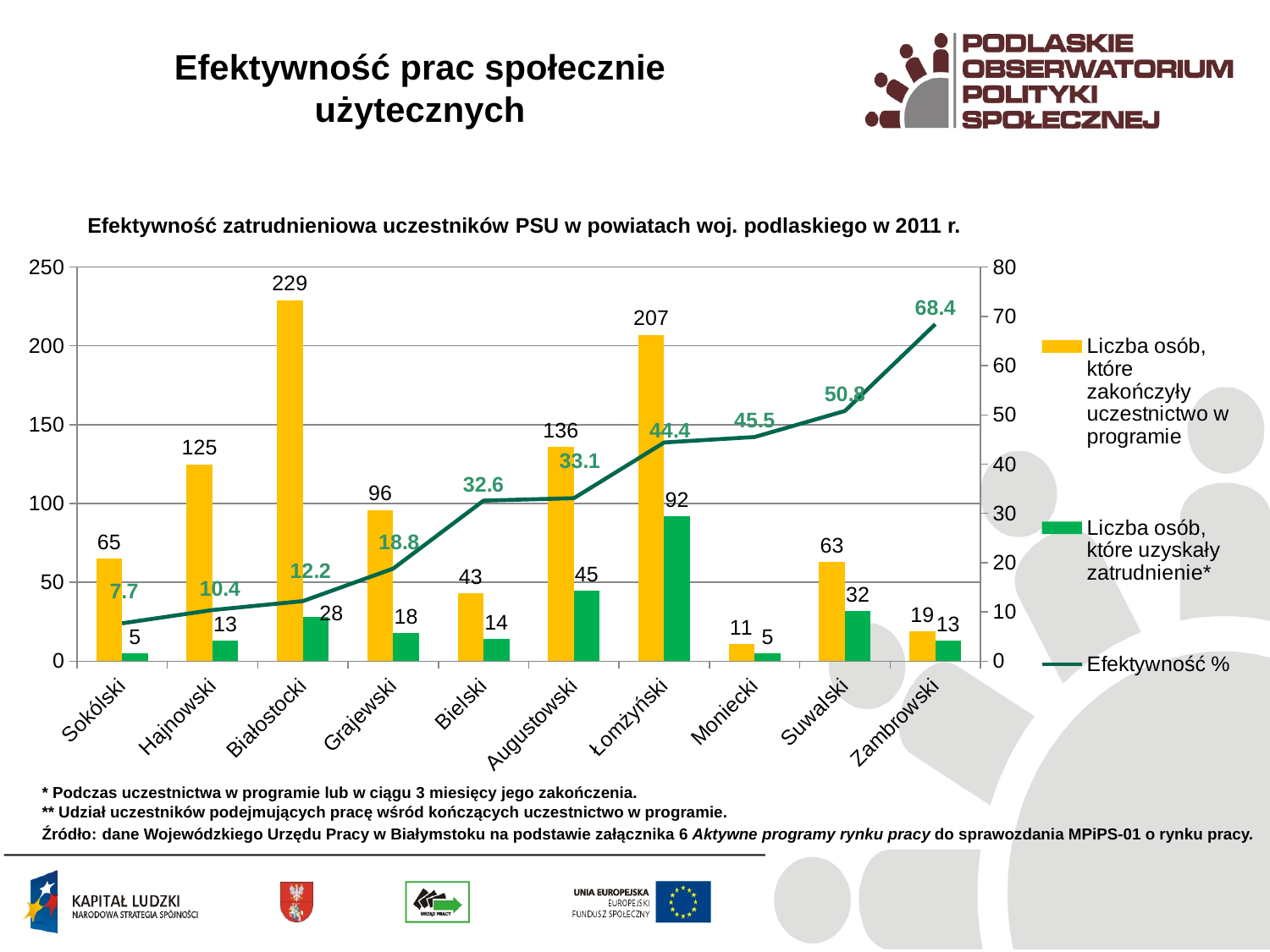
Which powiat has the highest number of people who completed participation in the programme? Białostocki What is the title of the chart? Efektywność zatrudnieniowa uczestników PSU w powiatach woj. podlaskiego w 2011 r. Which is larger: the number of people who obtained employment in Suwalski or in Grajewski? Suwalski Does the effectiveness (Efektywność %) line rise or fall from Sokólski to Zambrowski? Rises Which powiat has the lowest effectiveness (Efektywność %)? Sokólski What kind of chart is this? Combined bar and line chart How many people obtained employment in the Łomżyński powiat? 92 How many series does the legend list? 3 What is the difference between the number of people who completed the programme and the number who obtained employment in the Augustowski powiat? 91 How many people completed participation in the programme in the Białostocki powiat? 229 How many powiats (categories) are shown on the x axis? 10 What is the effectiveness (Efektywność %) for the Zambrowski powiat? 68.4